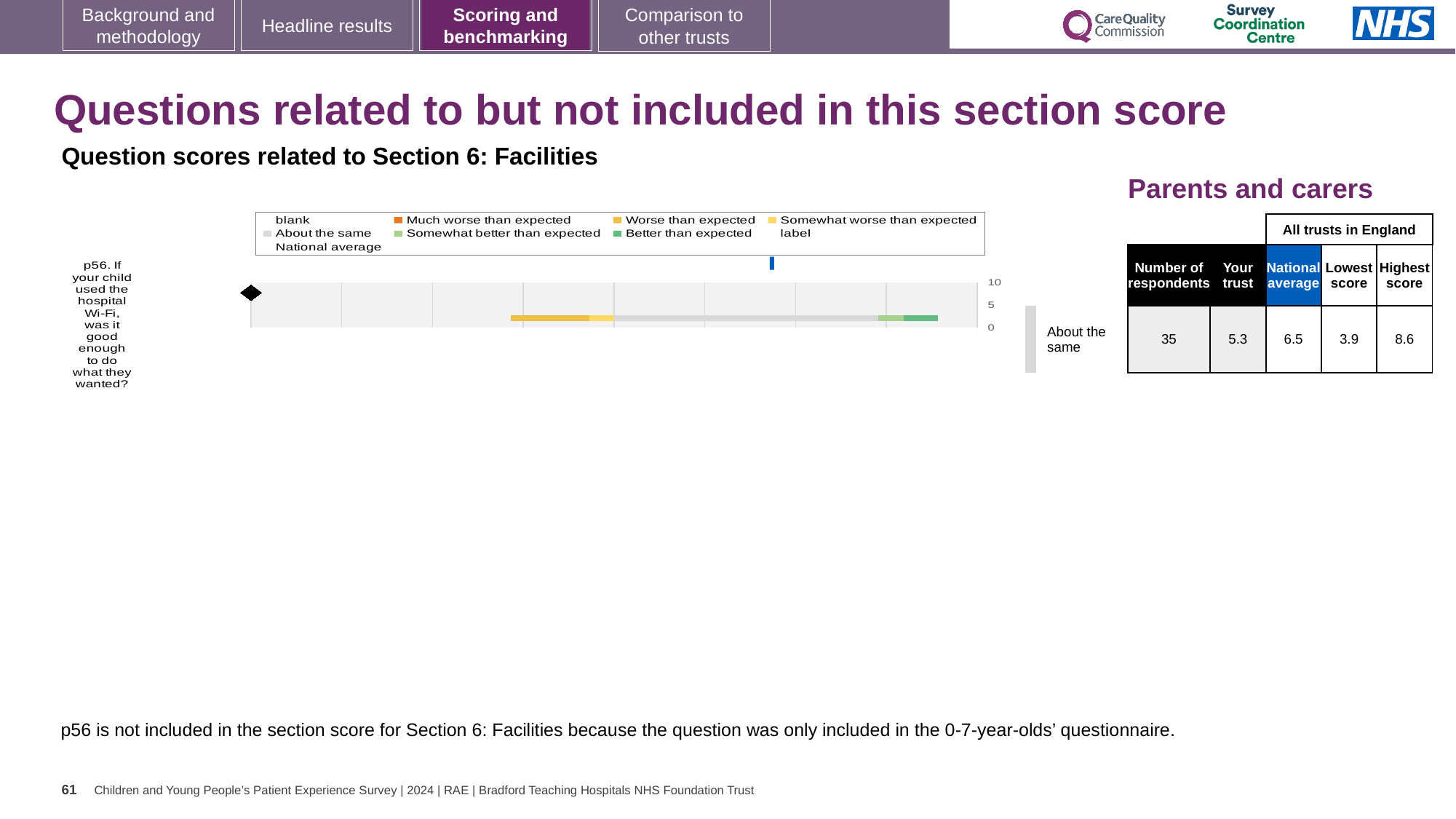
How many respondents answered question p56? 35 What benchmark category label is shown next to the p56 bar? About the same What is the difference between the highest and lowest scores for question p56? 4.7 Which is larger for question p56: the trust's score or the national average? national average What is the national average score for question p56? 6.5 What kind of chart is used to show the p56 question score? bar chart What is the trust's score for question p56 about hospital Wi-Fi? 5.3 What is the highest score among all trusts in England for question p56? 8.6 How many questions (categories) are plotted on the chart? 1 How many entries does the chart legend list? 9 What is the lowest score among all trusts in England for question p56? 3.9 What is the difference between the national average and the trust's score for question p56? 1.2